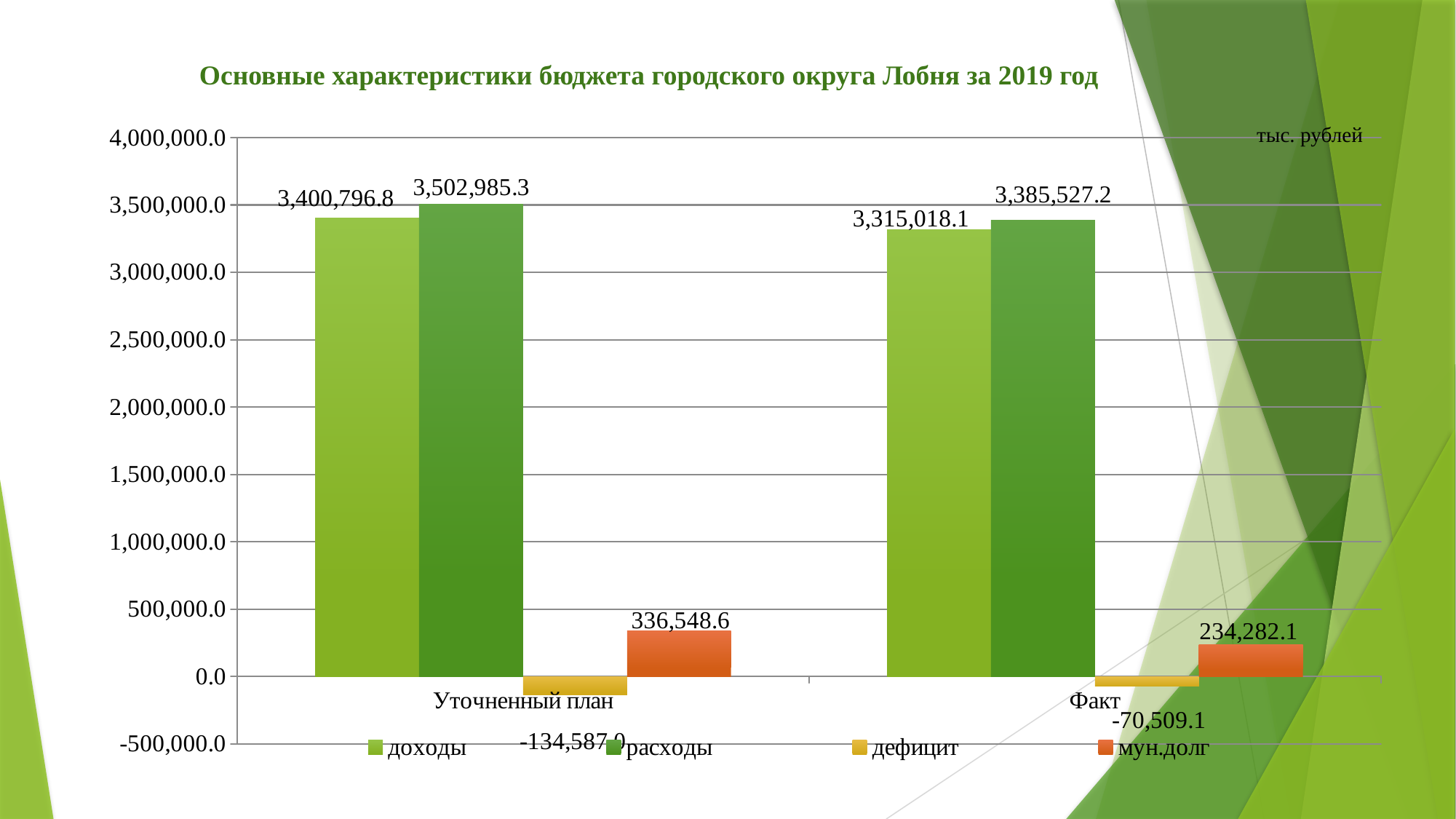
What kind of chart is shown on the slide? bar chart What is the difference between расходы and доходы for Факт? 70,509.1 What is the value of доходы for Уточненный план? 3,400,796.8 What unit is indicated in the top right corner of the chart? тыс. рублей How many series does the legend list? 4 Which series has the highest value in the Факт category? расходы Which is larger: доходы for Уточненный план or доходы for Факт? доходы for Уточненный план What is the value of мун.долг for Уточненный план? 336,548.6 What is the difference between мун.долг for Уточненный план and мун.долг for Факт? 102,266.5 What is the value of дефицит for Факт? -70,509.1 What is the value of расходы for Факт? 3,385,527.2 Which series has the lowest value in the Уточненный план category? дефицит